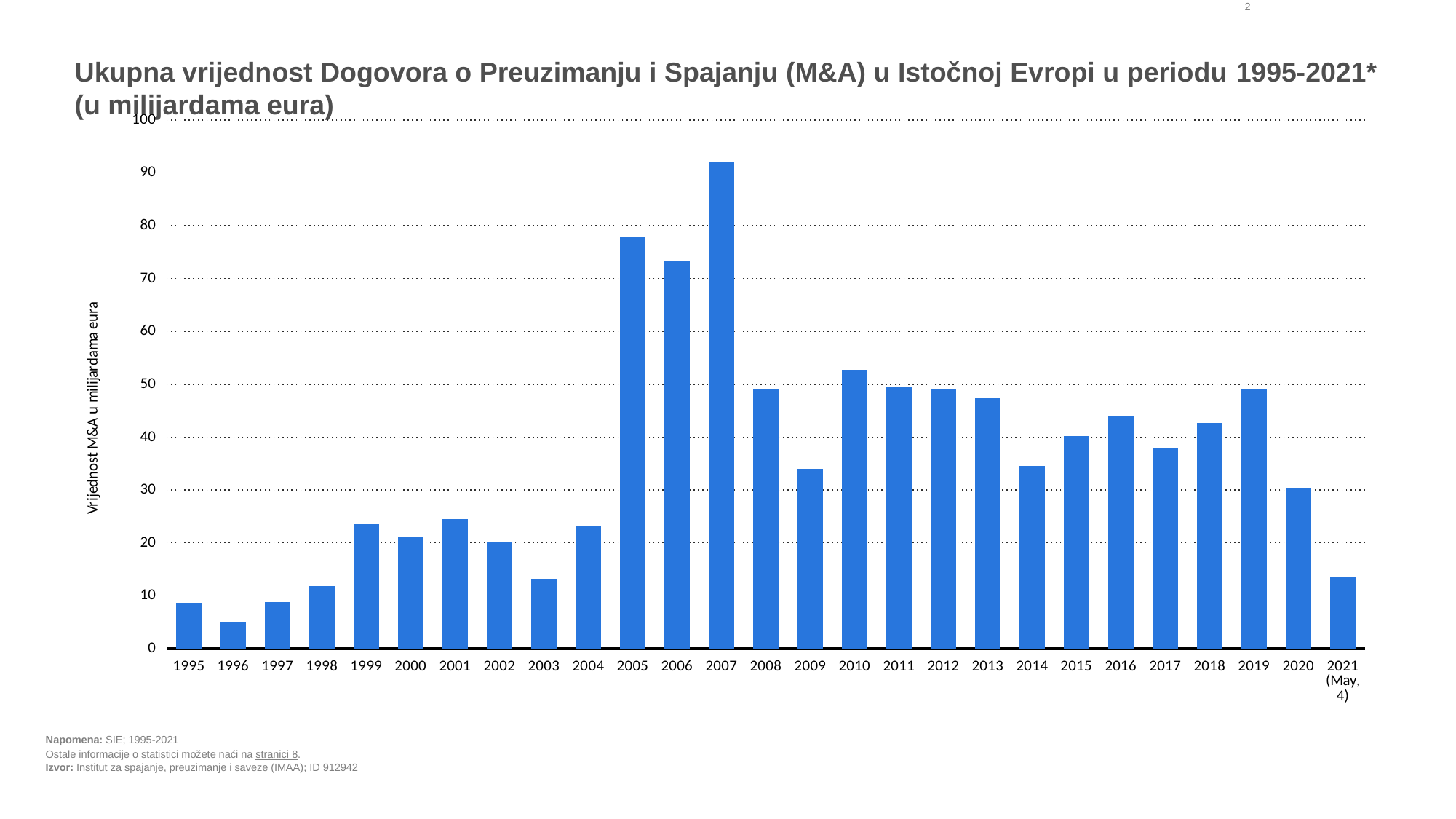
Is the value for 2007 greater or less than 90? greater Is the value for 1996 greater or less than 10? less What is the label on the vertical axis of the chart? Vrijednost M&A u milijardama eura Is the value for 2010 greater or less than 50? greater Which year has the highest M&A deal value? 2007 How many years (bars) are plotted on the chart? 27 What kind of chart is shown on the slide? Bar chart Do the values rise or fall from 2019 to 2021 (May, 4)? Fall Which year has the larger value, 2005 or 2006? 2005 Which year has the lowest M&A deal value? 1996